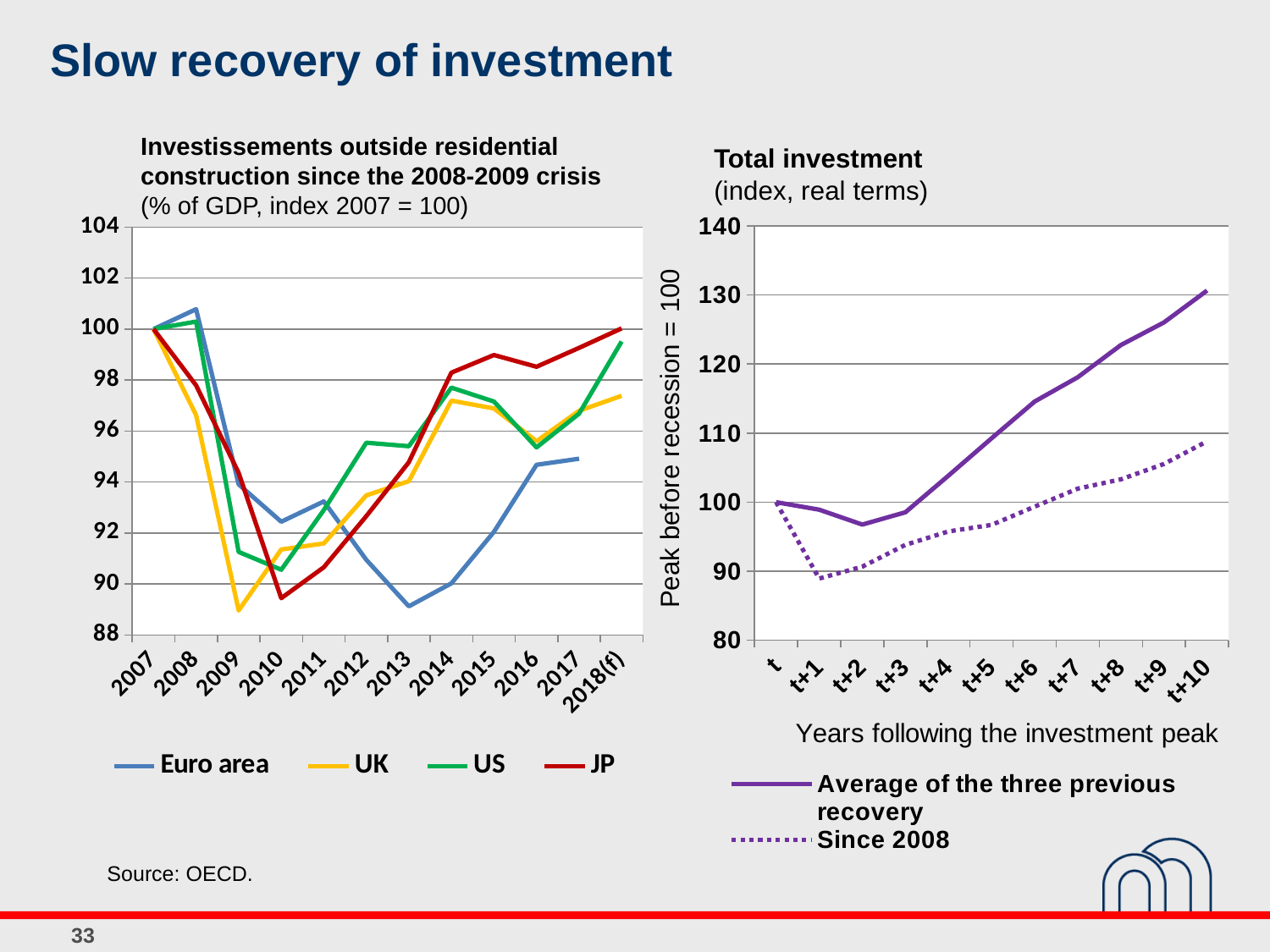
In the left chart, is the value for US in 2012 greater or less than 94? greater In the left chart, how many years are shown on the x axis? 12 In the right chart titled 'Total investment', which series is higher at t+5: 'Average of the three previous recovery' or 'Since 2008'? Average of the three previous recovery In the left chart, which series has the highest value in 2018(f)? JP In the left chart, which series has the lowest value in 2013? Euro area How many series does the legend of the left chart list? 4 In the right chart titled 'Total investment', is the value for 'Since 2008' at t+1 greater or less than 90? less In the left chart, which series has the lowest value in 2009? UK What type of chart is the left chart titled 'Investissements outside residential construction since the 2008-2009 crisis'? Line chart In the right chart titled 'Total investment', how many points are shown on the x axis? 11 In the left chart, is the value for UK in 2009 greater or less than 90? less In the right chart titled 'Total investment', how many series does the legend list? 2